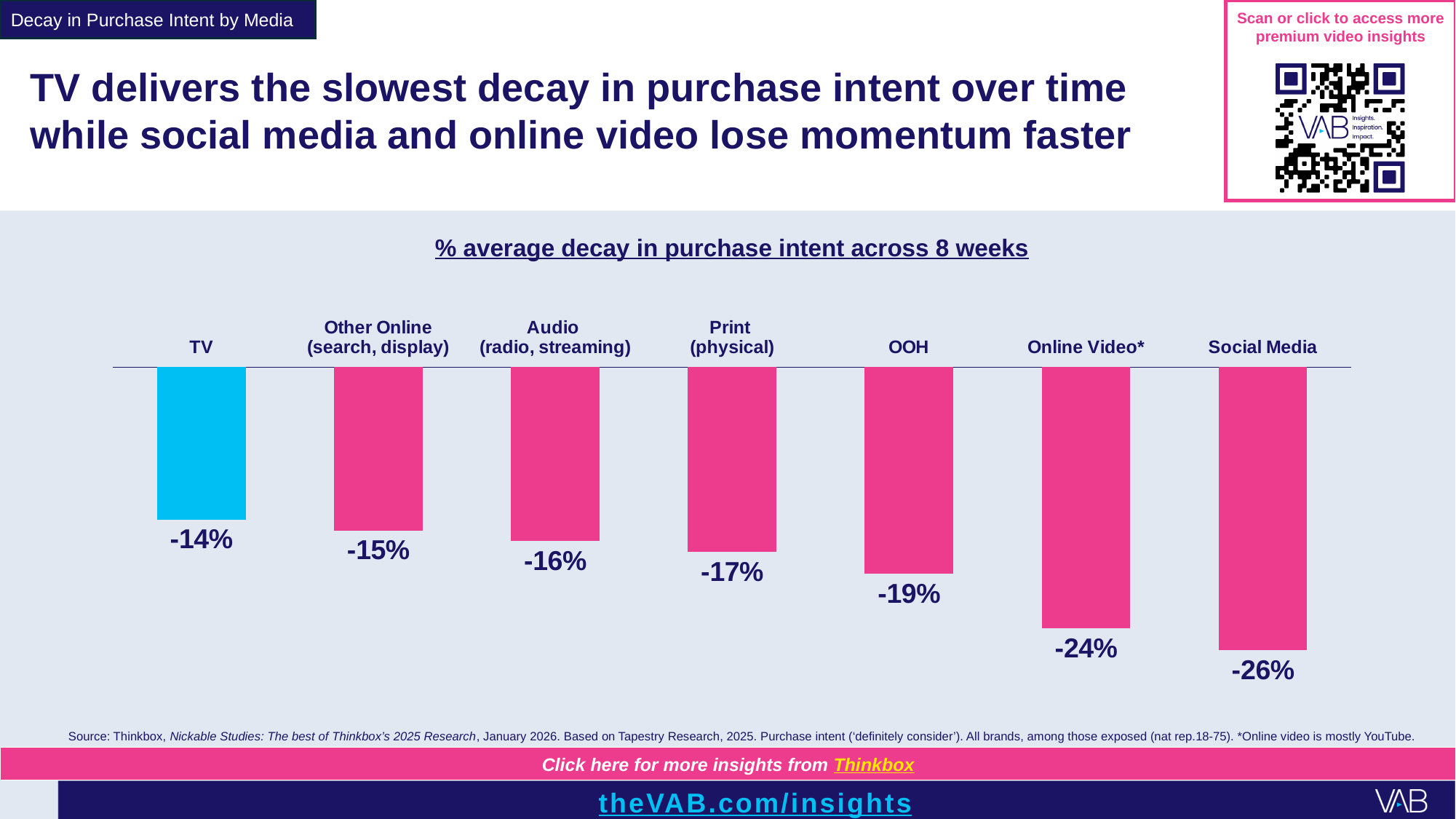
Which media category shows the largest decay in purchase intent (most negative value)? Social Media Do the decay values become more negative or less negative moving from left to right across the chart? More negative What is the % average decay in purchase intent for TV? -14% Which bar is coloured differently (blue) from the others? TV What is the difference in percentage points between the decay for Social Media and TV? 12 percentage points Which has a larger decay in purchase intent, Print (physical) or Audio (radio, streaming)? Print (physical) Which media category shows the smallest decay in purchase intent? TV What is the value shown for Online Video*? -24% What type of chart is used on this slide? Bar chart What is the value shown for Social Media? -26% How many media categories are shown in the chart? 7 What is the value shown for OOH? -19%